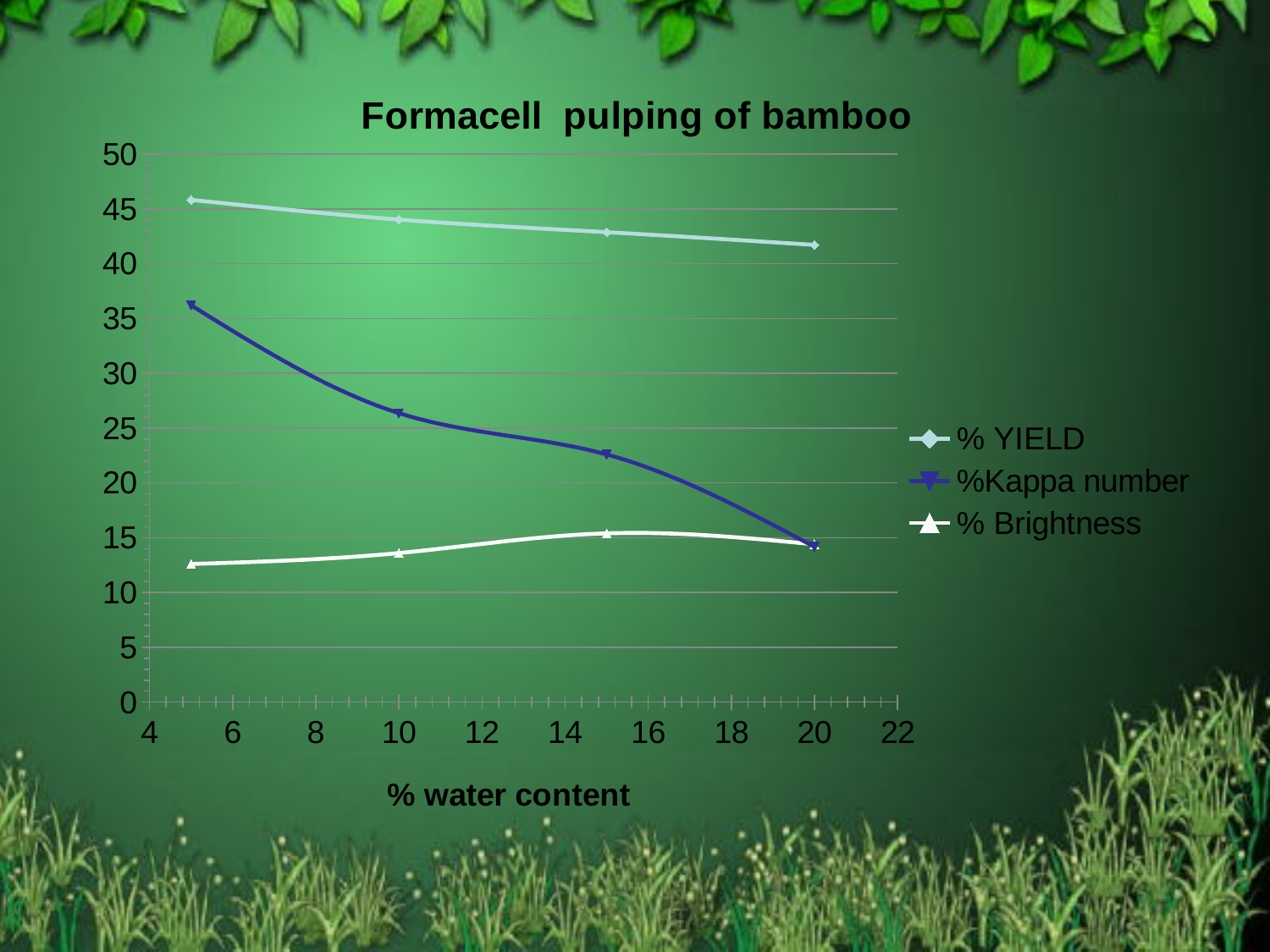
What is the title of the chart? Formacell pulping of bamboo Is the % YIELD value at 20% water content greater or less than 40? greater Does the %Kappa number series rise or fall as % water content increases? fall Is the %Kappa number value at 5% water content greater or less than 35? greater Does the % YIELD series rise or fall as % water content increases? fall How many data points are plotted for the % YIELD series? 4 How many series does the legend list? 3 Which series has the highest value at 10% water content? % YIELD Is the % Brightness value at 5% water content greater or less than 15? less What kind of chart is shown on the slide? line chart What is the label of the x axis? % water content